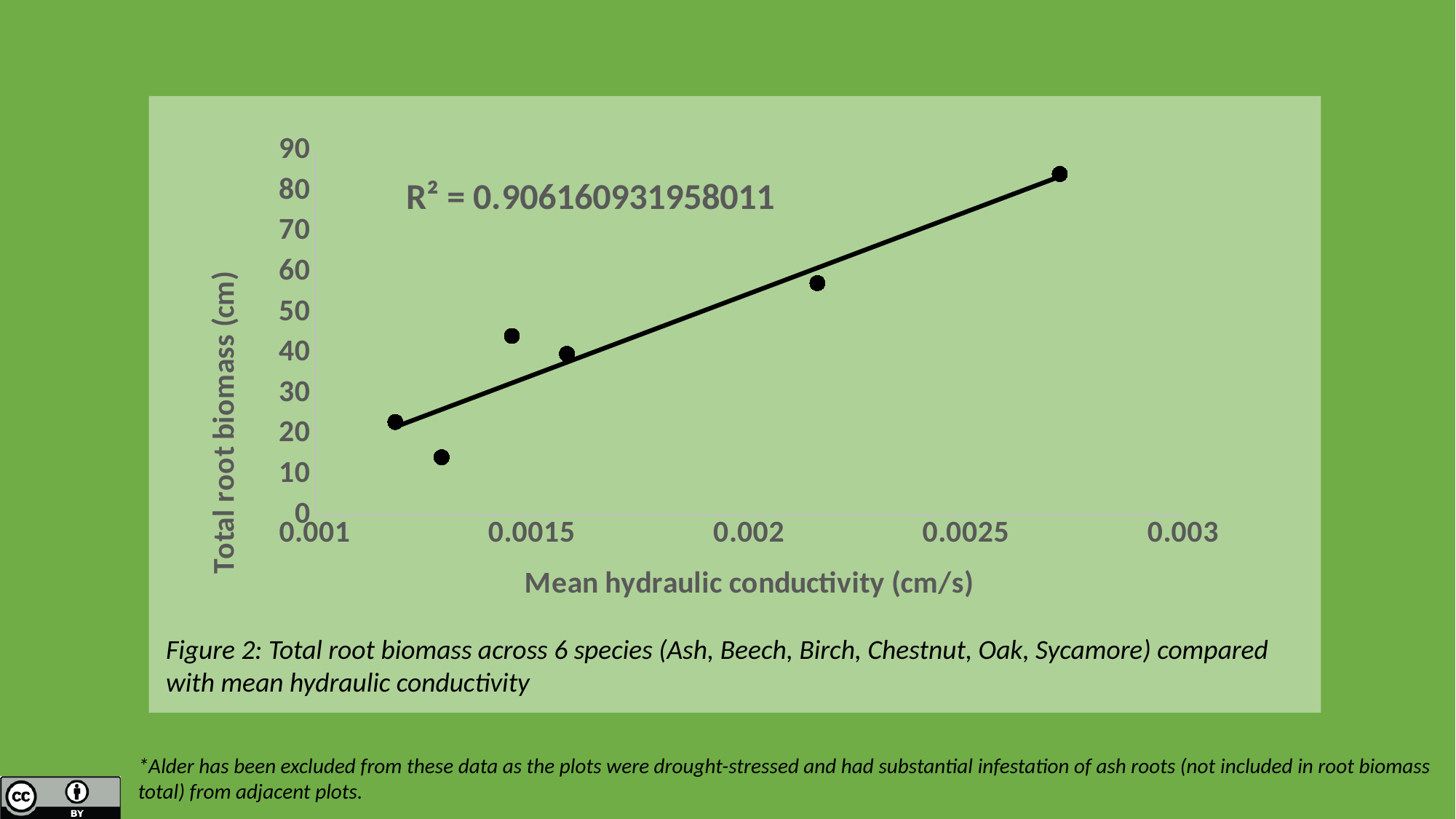
Which point has the higher total root biomass: the rightmost point or the leftmost point? The rightmost point What kind of chart is shown on the slide? Scatter plot What is the title of the x axis? Mean hydraulic conductivity (cm/s) What R² value is printed on the chart? R² = 0.906160931958011 Is the mean hydraulic conductivity of the leftmost point greater or less than 0.0015? less Is the total root biomass of the lowest point on the chart greater or less than 20? less How many data points are plotted on the chart? 6 Is the total root biomass of the point near 0.0022 cm/s greater or less than 50? greater Does total root biomass rise or fall as mean hydraulic conductivity increases along the x axis? Rises